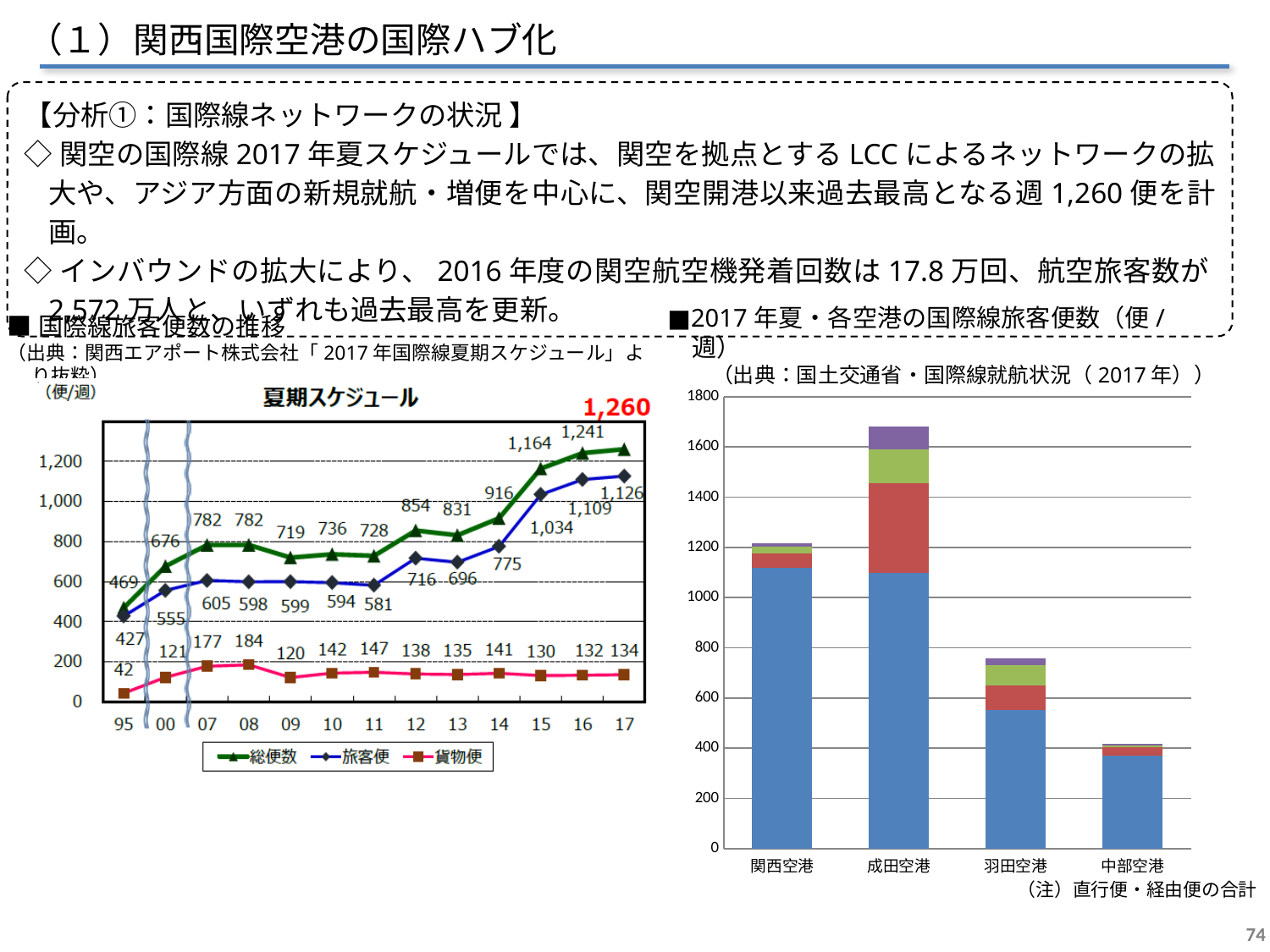
In the left chart (夏期スケジュール), what is the value of 総便数 for 17? 1,260 What kind of chart is the right chart (2017年夏・各空港の国際線旅客便数)? stacked bar chart In the left chart (夏期スケジュール), which is larger, the 旅客便 value for 12 or for 13? 12 In the left chart (夏期スケジュール), does the 総便数 series rise or fall from 14 to 17? rise In the right chart (2017年夏・各空港の国際線旅客便数), is the total for 中部空港 greater or less than 600? less In the left chart (夏期スケジュール), which year has the lowest 総便数 value? 95 In the left chart (夏期スケジュール), what is the difference between the 総便数 values for 17 and 16? 19 In the left chart (夏期スケジュール), what is the value of 貨物便 for 08? 184 In the right chart (2017年夏・各空港の国際線旅客便数), which airport has the tallest bar? 成田空港 In the left chart (夏期スケジュール), how many years are plotted on the x axis? 13 In the left chart (夏期スケジュール), what is the value of 旅客便 for 15? 1,034 In the left chart (夏期スケジュール), how many series does the legend list? 3